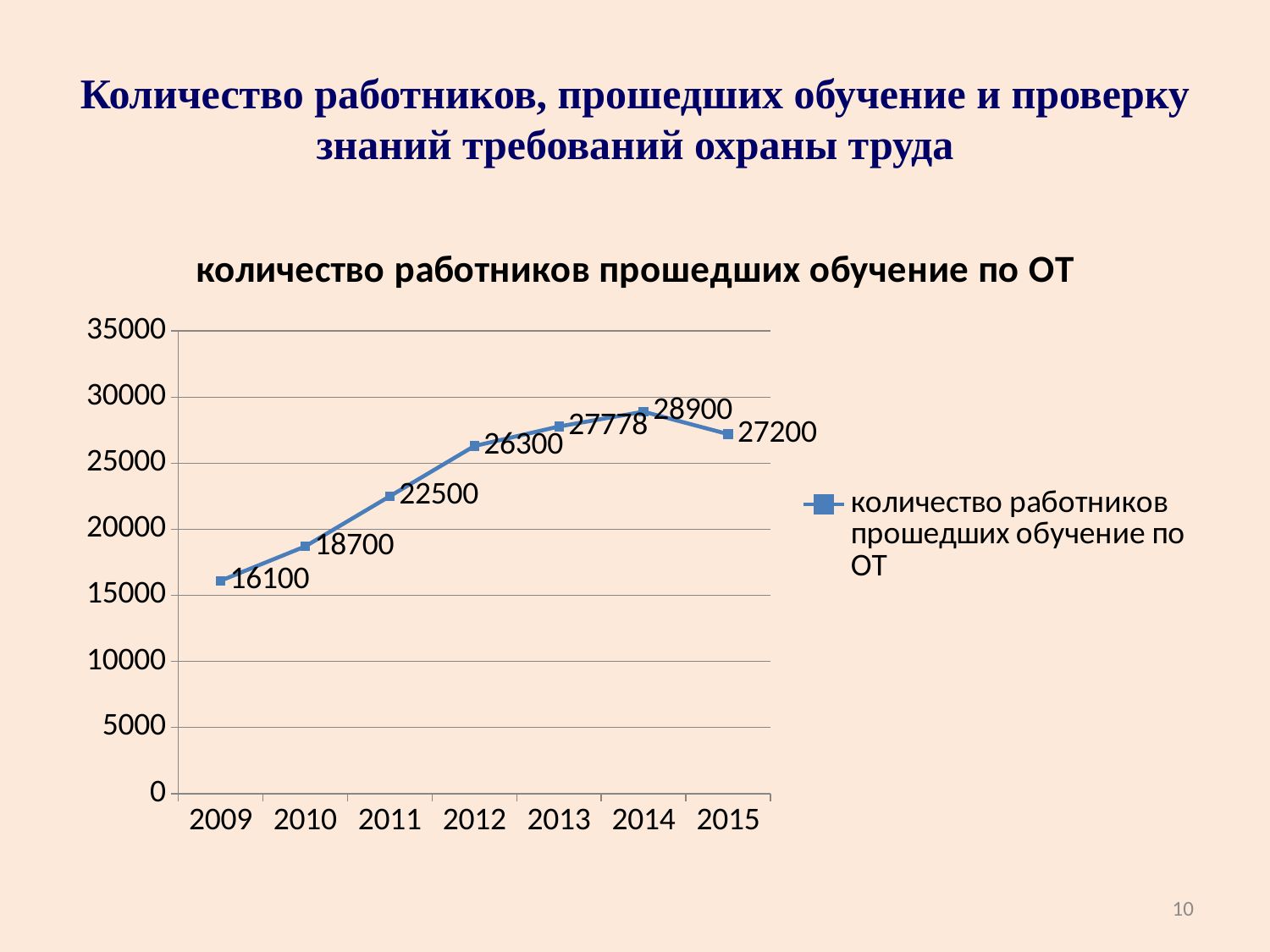
What is the value for 2013? 27778 What is the difference between the values for 2011 and 2010? 3800 Does the value rise or fall from 2009 to 2014? rise What is the value for 2009? 16100 What is the difference between the values for 2014 and 2015? 1700 What type of chart is shown on the slide? line chart Which year has the highest value? 2014 What is the value for 2015? 27200 Which is larger, the value for 2012 or the value for 2015? 2015 How many series does the legend list? 1 Which year has the lowest value? 2009 How many years are plotted on the x axis? 7